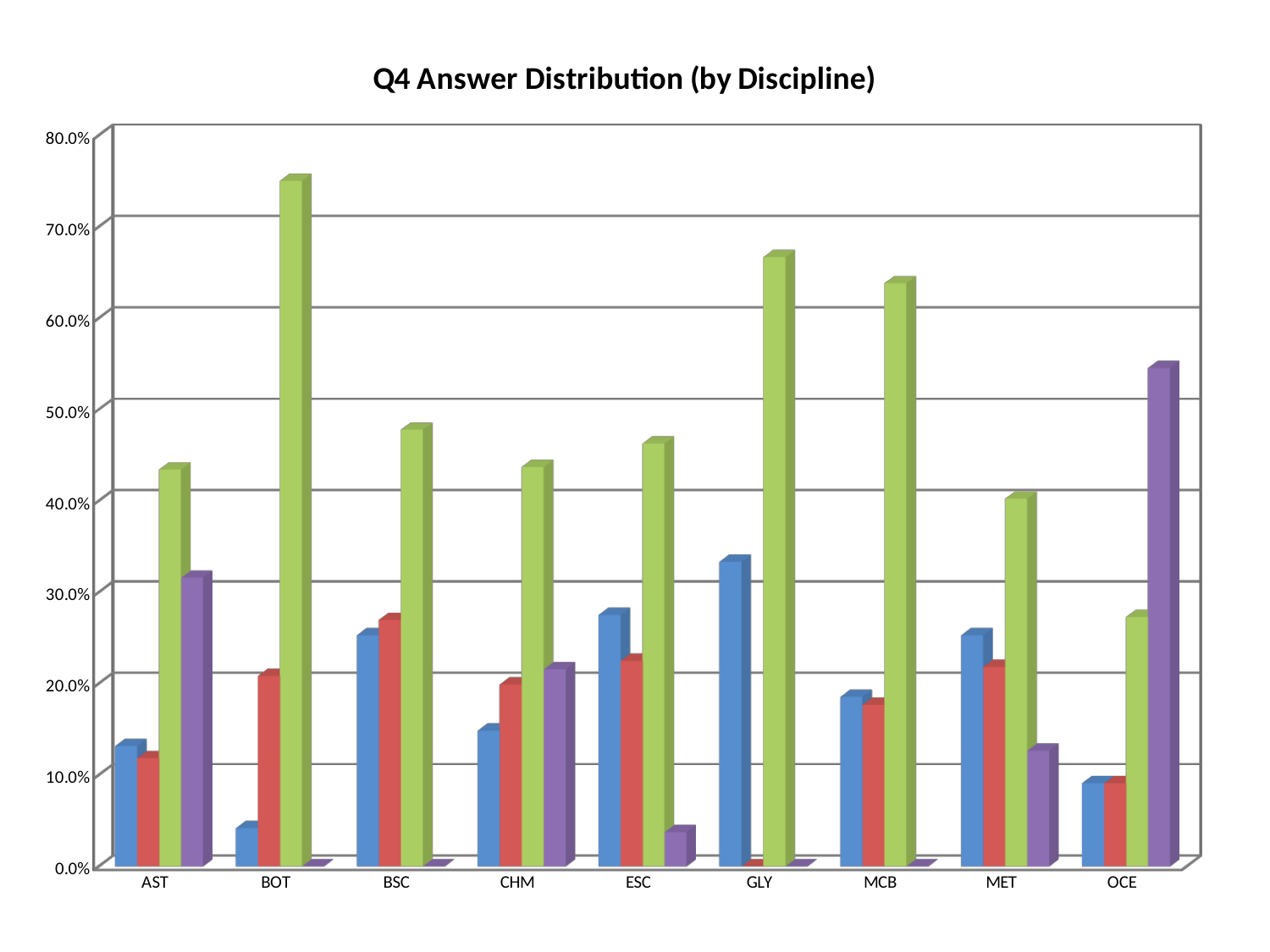
Which is larger, the green bar for GLY or the green bar for MET? GLY What type of chart is shown on the slide? bar chart Is the green bar for BSC greater or less than 50.0%? less Which discipline has the tallest purple bar? OCE How many disciplines are shown along the x axis? 9 Is the blue bar for GLY greater or less than 30.0%? greater Is the purple bar for OCE greater or less than 50.0%? greater Which discipline has the tallest green bar? BOT How many bars are plotted for each discipline? 4 What is the title of the chart? Q4 Answer Distribution (by Discipline)